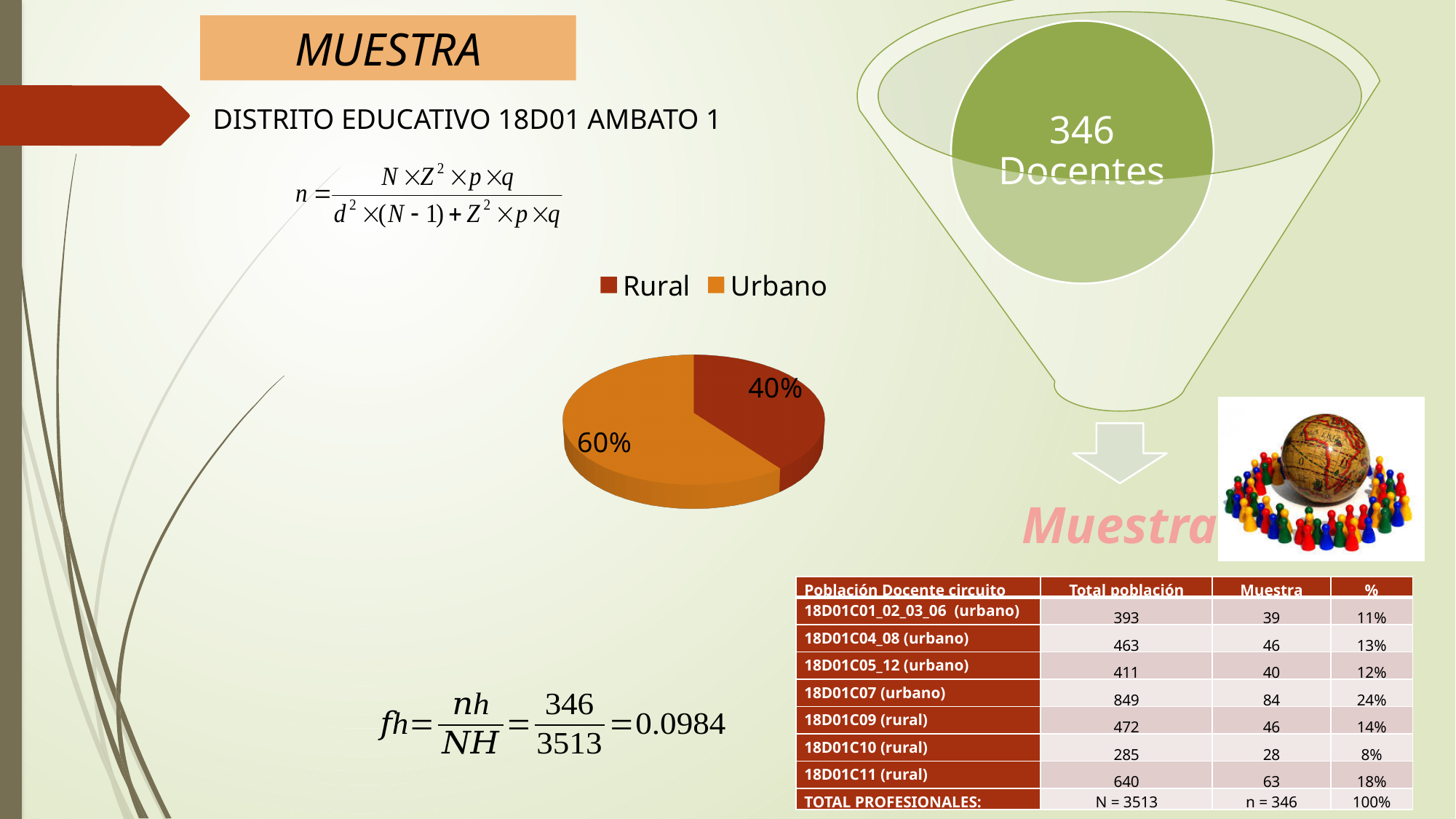
What kind of chart is shown on the slide? pie chart What are the two categories listed in the pie chart legend? Rural and Urbano What is the difference in percentage points between the Urbano and Rural slices? 20% How many entries does the pie chart legend list? 2 How many slices does the pie chart have? 2 Which slice of the pie chart is the smallest? Rural Which is larger in the pie chart, Rural or Urbano? Urbano What share of the pie chart does Rural represent? 40% Which slice of the pie chart is the largest? Urbano Is the Rural share of the pie chart greater or less than 50%? less What colour is the Urbano slice in the pie chart? orange What share of the pie chart does Urbano represent? 60%